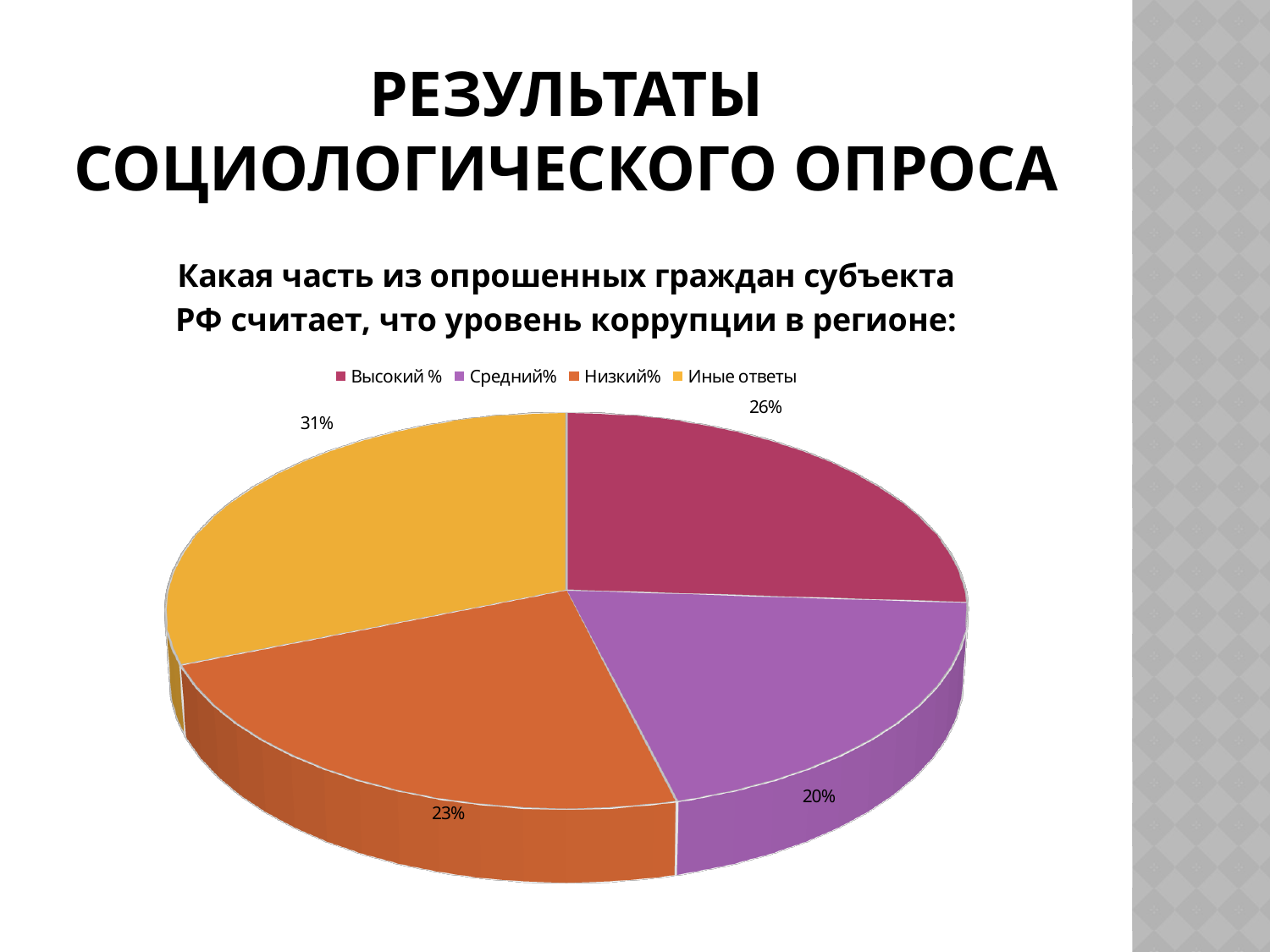
What share of respondents answered "Средний%"? 20% What share of respondents gave "Иные ответы"? 31% Which category has the largest slice of the pie? Иные ответы What colour is the slice for "Иные ответы"? Yellow What is the difference in percentage points between "Иные ответы" and "Средний%"? 11 Which is larger, the share for "Высокий %" or the share for "Низкий%"? Высокий % What kind of chart is shown on the slide? Pie chart Which category has the smallest slice of the pie? Средний% How many slices does the pie chart have? 4 What share of respondents answered "Низкий%"? 23% What share of respondents answered "Высокий %"? 26% How many entries does the legend list? 4